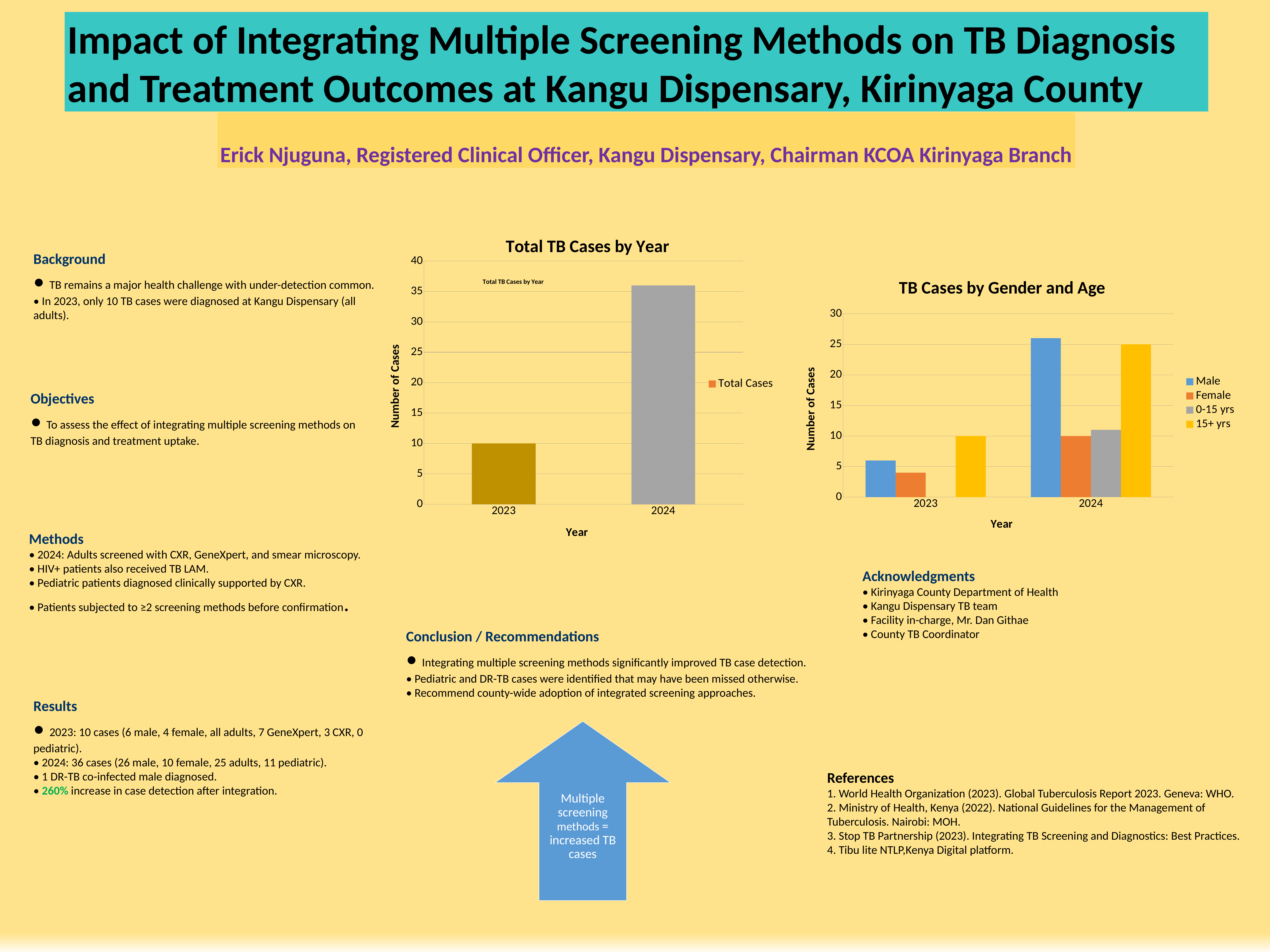
In the 'TB Cases by Gender and Age' chart, how many series does the legend list? 4 In the 'TB Cases by Gender and Age' chart, what is the value for 15+ yrs in 2024? 25 In the 'Total TB Cases by Year' chart, is the value for 2024 greater or less than 35? greater In the 'Total TB Cases by Year' chart, do the values rise or fall from 2023 to 2024? Rise In the 'Total TB Cases by Year' chart, what is the number of cases for 2023? 10 In the 'Total TB Cases by Year' chart, which year has the higher number of cases? 2024 In the 'TB Cases by Gender and Age' chart, what is the value for Female in 2024? 10 What kind of chart is 'Total TB Cases by Year'? Bar chart In the 'Total TB Cases by Year' chart, how many years are shown on the x axis? 2 In the 'TB Cases by Gender and Age' chart, is the value for Male in 2024 greater or less than 25? greater In the 'TB Cases by Gender and Age' chart, which is larger in 2023: Male or Female? Male In the 'TB Cases by Gender and Age' chart, which series is shown in yellow in the legend? 15+ yrs